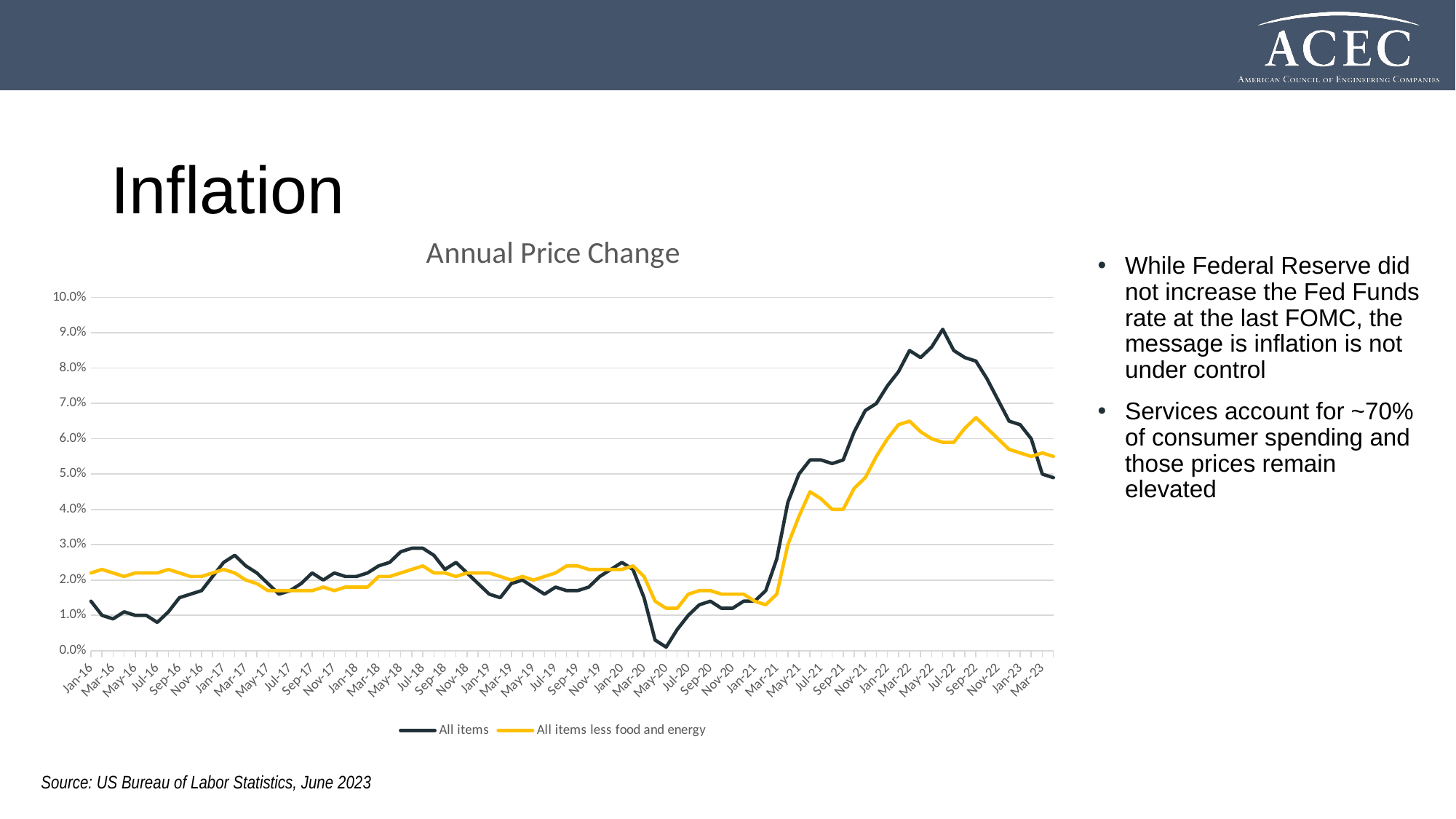
Is the peak value of the All items less food and energy series in 2022 greater or less than 7.0%? less What is the title of the chart? Annual Price Change How many series does the chart's legend list? 2 What kind of chart is shown on the slide? line chart Is the value for All items around May-20 greater or less than 1.0%? less Around May-20, which series has the higher value, All items or All items less food and energy? All items less food and energy Which series is drawn in yellow in the chart? All items less food and energy Which series drops to the lowest value anywhere on the chart? All items Does the All items series rise or fall between Mar-21 and its mid-2022 peak? rise Is the peak value of the All items series in 2022 greater or less than 8.0%? greater Does the All items series rise or fall from its mid-2022 peak to Mar-23? fall Which series reaches the highest value anywhere on the chart? All items